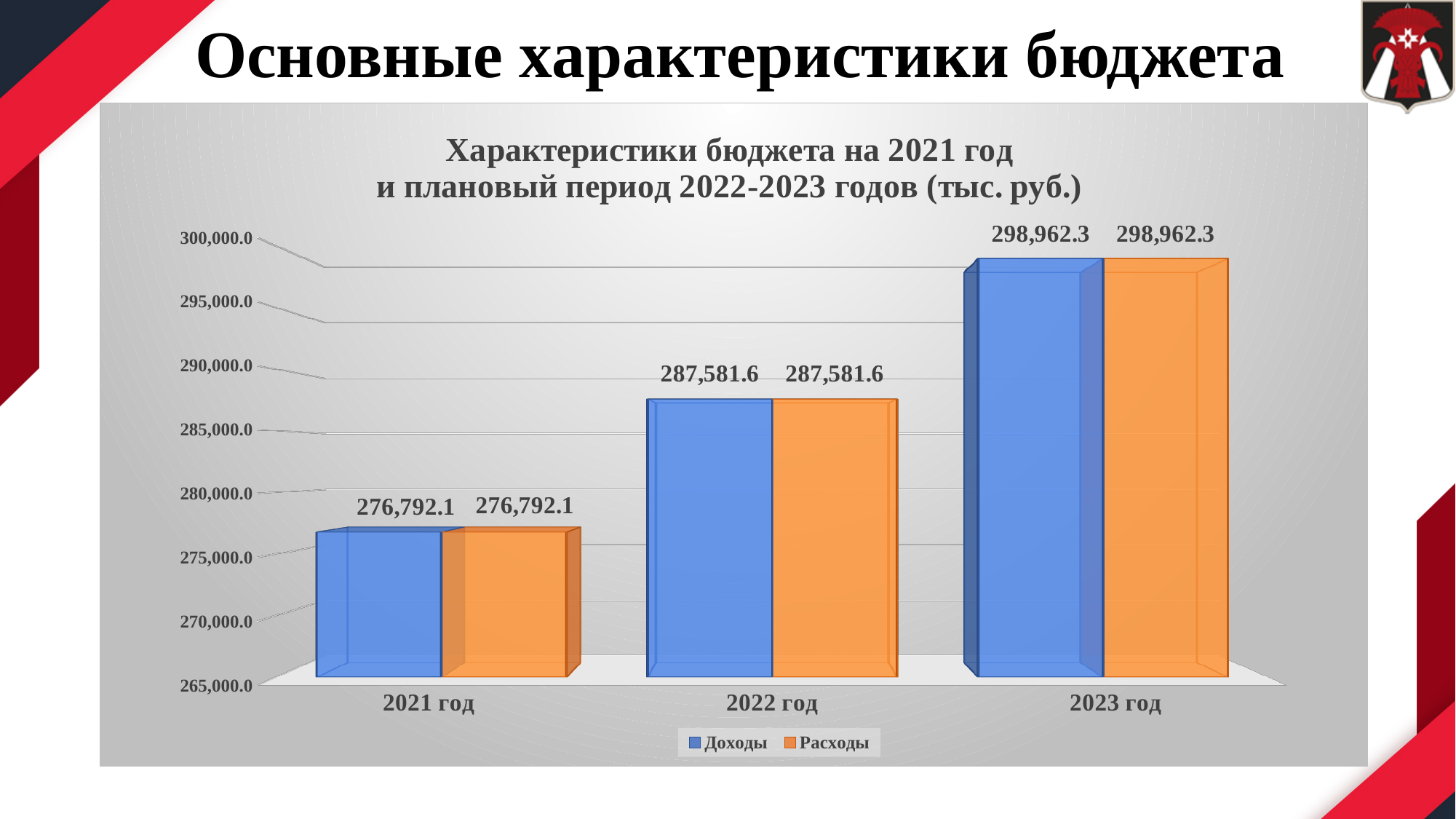
How many years are shown on the x axis? 3 What is the value of Доходы for 2023 год? 298,962.3 What kind of chart is shown on the slide? Bar chart Which year has the highest value for Доходы? 2023 год Which year has the lowest value for Расходы? 2021 год Do the values for Расходы rise or fall from 2021 год to 2023 год? Rise What is the value of Расходы for 2022 год? 287,581.6 How many series does the legend list? 2 What is the difference between Расходы in 2022 год and Расходы in 2021 год? 10,789.5 Which is larger: Доходы in 2022 год or Доходы in 2021 год? Доходы in 2022 год What is the value of Доходы for 2021 год? 276,792.1 What is the difference between Доходы in 2023 год and Доходы in 2021 год? 22,170.2